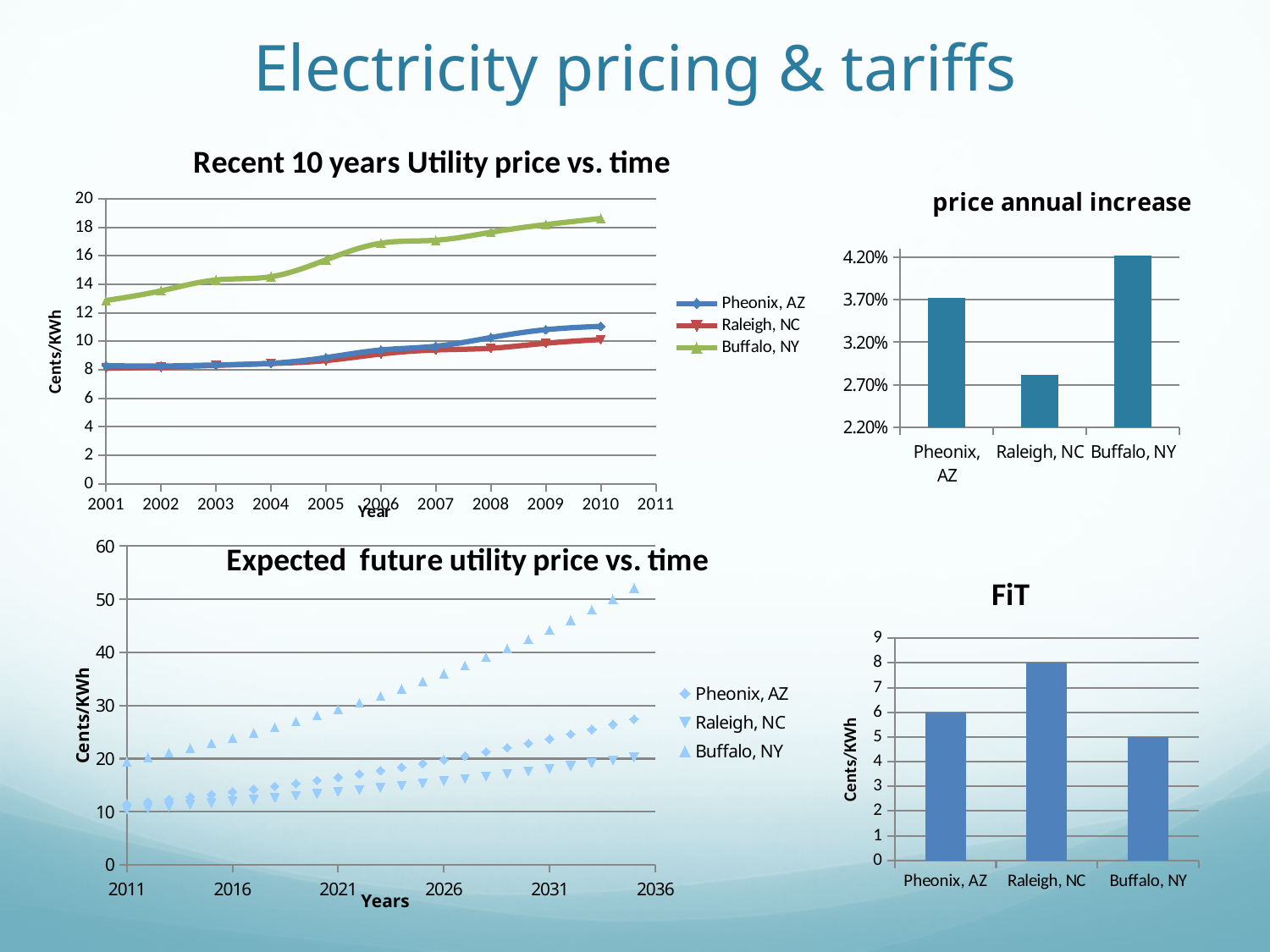
In the FiT chart, what is the value for Raleigh, NC? 8 In the FiT chart, which city has the lowest value? Buffalo, NY In the price annual increase chart, is the value for Raleigh, NC greater or less than 3.20%? less In the FiT chart, what is the value for Pheonix, AZ? 6 How many series does the legend of the Expected future utility price vs. time chart list? 3 In the Recent 10 years Utility price vs. time chart, is the value for Buffalo, NY in 2010 greater or less than 16? greater In the price annual increase chart, how many cities are shown? 3 In the Recent 10 years Utility price vs. time chart, which city has the highest price in 2010? Buffalo, NY In the Expected future utility price vs. time chart, do the values for Buffalo, NY rise or fall from 2011 to 2036? rise In the price annual increase chart, which city has the highest annual increase? Buffalo, NY In the FiT chart, what is the difference between the values for Raleigh, NC and Buffalo, NY? 3 What kind of chart is the FiT chart? bar chart